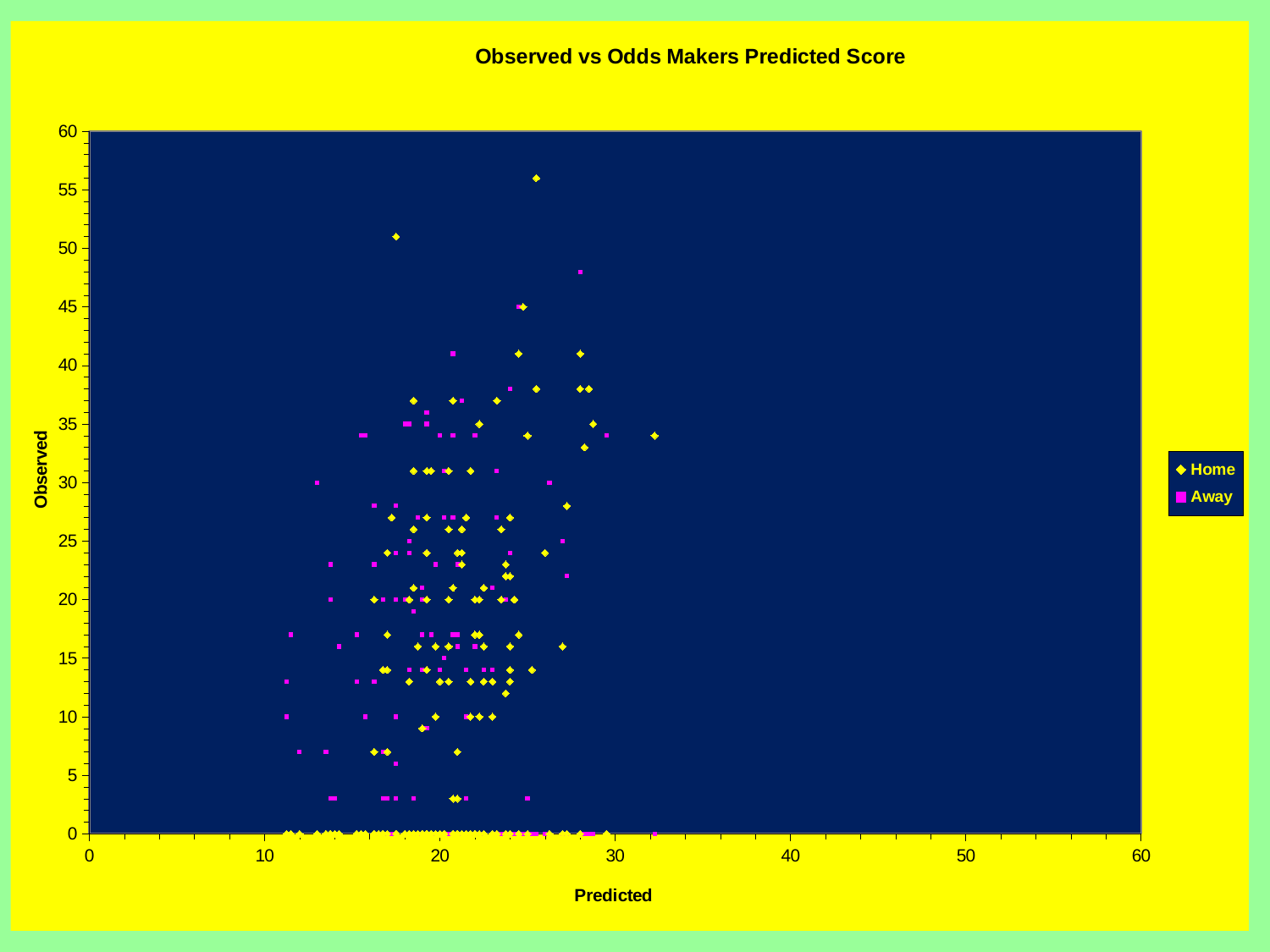
Is the smallest Predicted value of any point greater or less than 10? greater Is the highest Observed value for the Away series greater or less than 50? less How many series does the legend list? 2 Is the highest Observed value for the Home series greater or less than 50? greater Which series contains the point with the highest Observed value? Home What are the two series named in the legend? Home and Away What is the title of the chart? Observed vs Odds Makers Predicted Score What is the maximum value shown on the Observed axis? 60 What kind of chart is shown on the slide? scatter chart